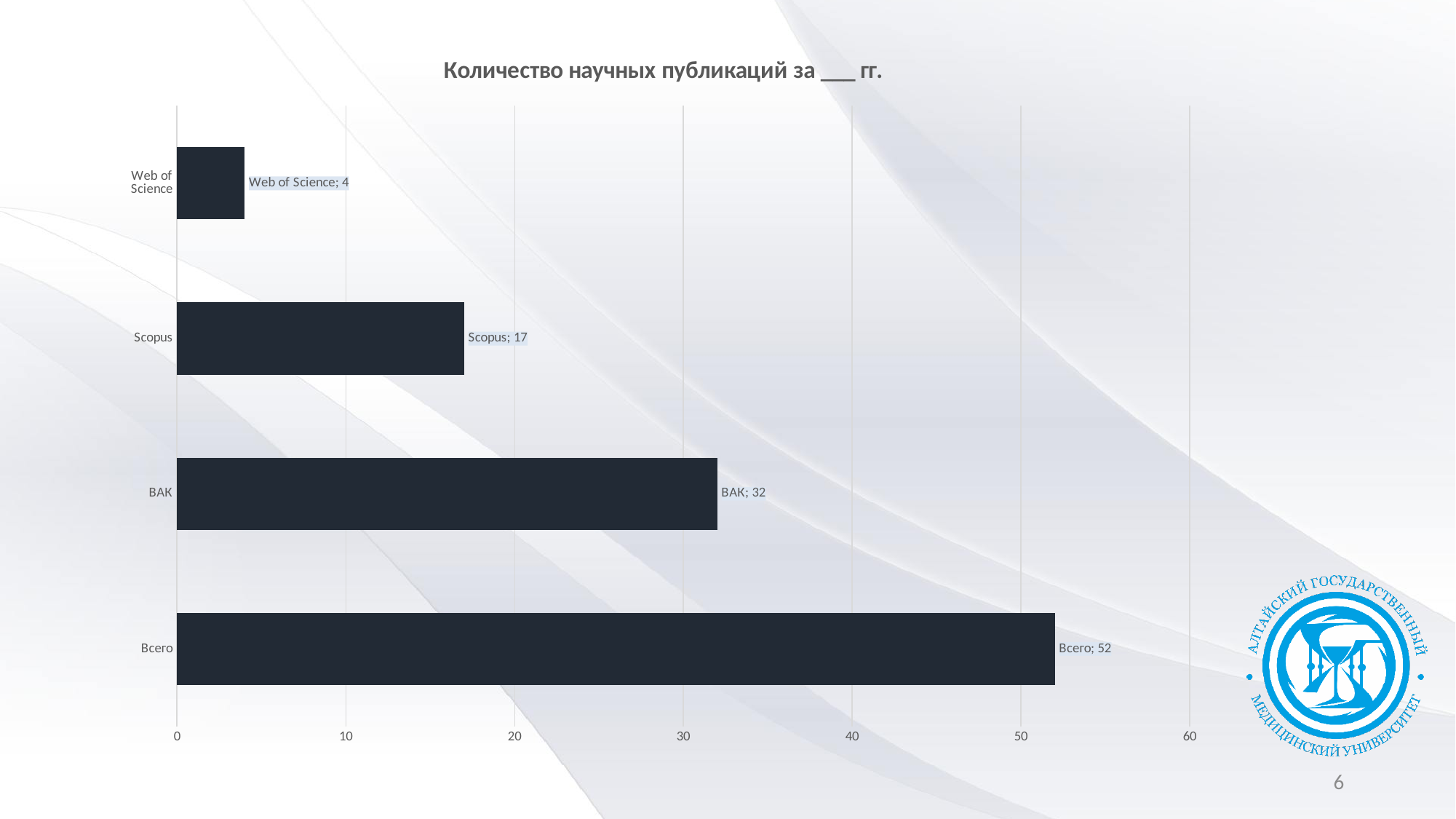
Is the value for ВАК greater or less than 30? greater What kind of chart is shown on the slide? bar chart What is the title of the chart? Количество научных публикаций за ___ гг. What is the value for ВАК? 32 What is the difference between the values for ВАК and Scopus? 15 Which category has the highest value? Всего Which is larger, the value for Scopus or the value for Web of Science? Scopus What is the value for Всего? 52 What is the value for Scopus? 17 Which category has the lowest value? Web of Science How many categories are shown in the chart? 4 What is the value for Web of Science? 4